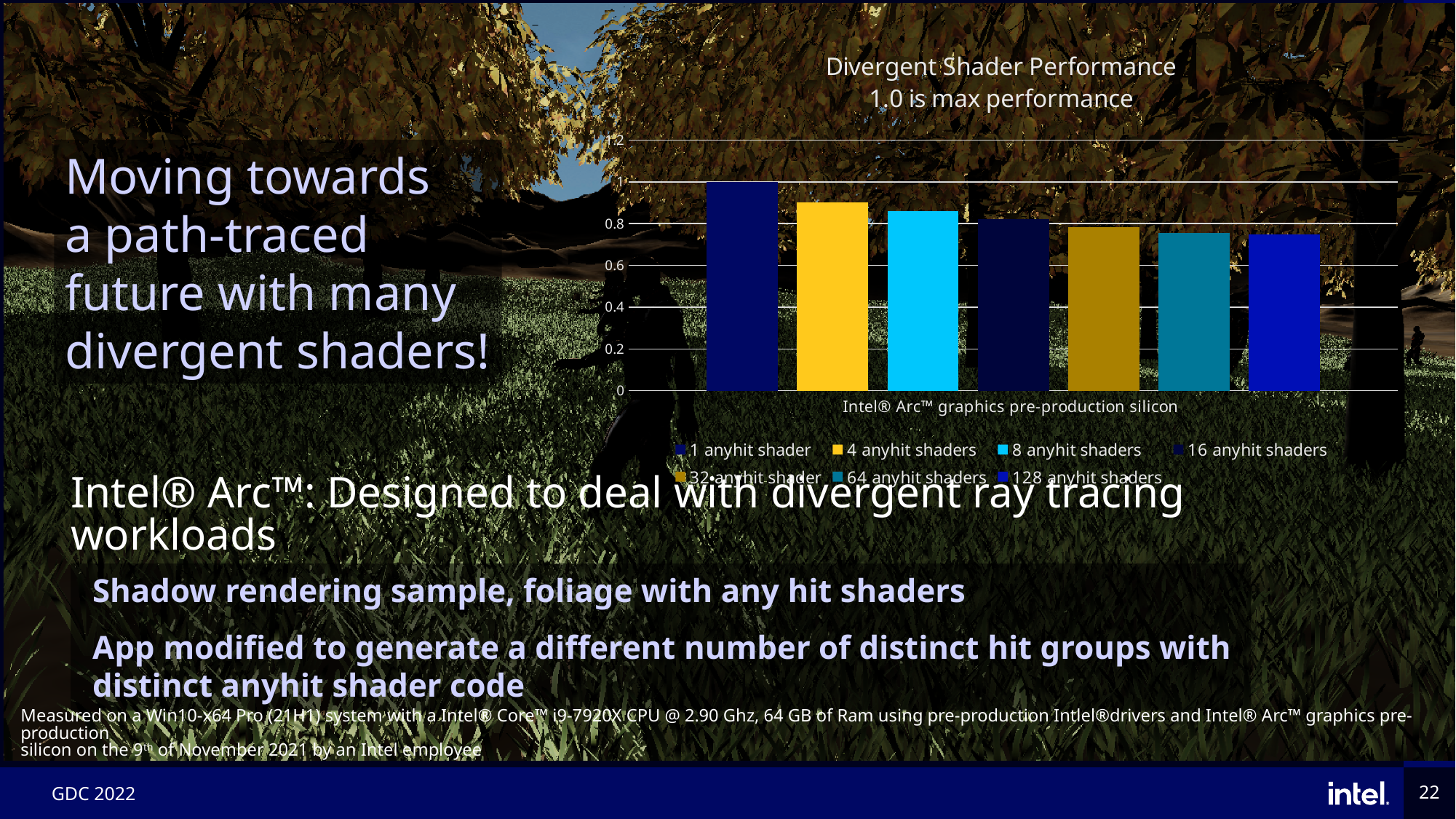
What kind of chart is shown on the slide? Bar chart What is the value for 1 anyhit shader? 1.0 Which series has the highest bar in the chart? 1 anyhit shader How many bars are plotted in the chart? 7 Is the value for 64 anyhit shaders greater or less than 0.8? less How many series does the chart legend list? 7 Is the value for 4 anyhit shaders greater or less than 0.8? greater Do the bar values rise or fall as the number of anyhit shaders increases from left to right? fall Which is larger, the value for 1 anyhit shader or the value for 128 anyhit shaders? 1 anyhit shader What is the title of the chart? Divergent Shader Performance Which is larger, the value for 4 anyhit shaders or the value for 64 anyhit shaders? 4 anyhit shaders Is the value for 128 anyhit shaders greater or less than 0.8? less